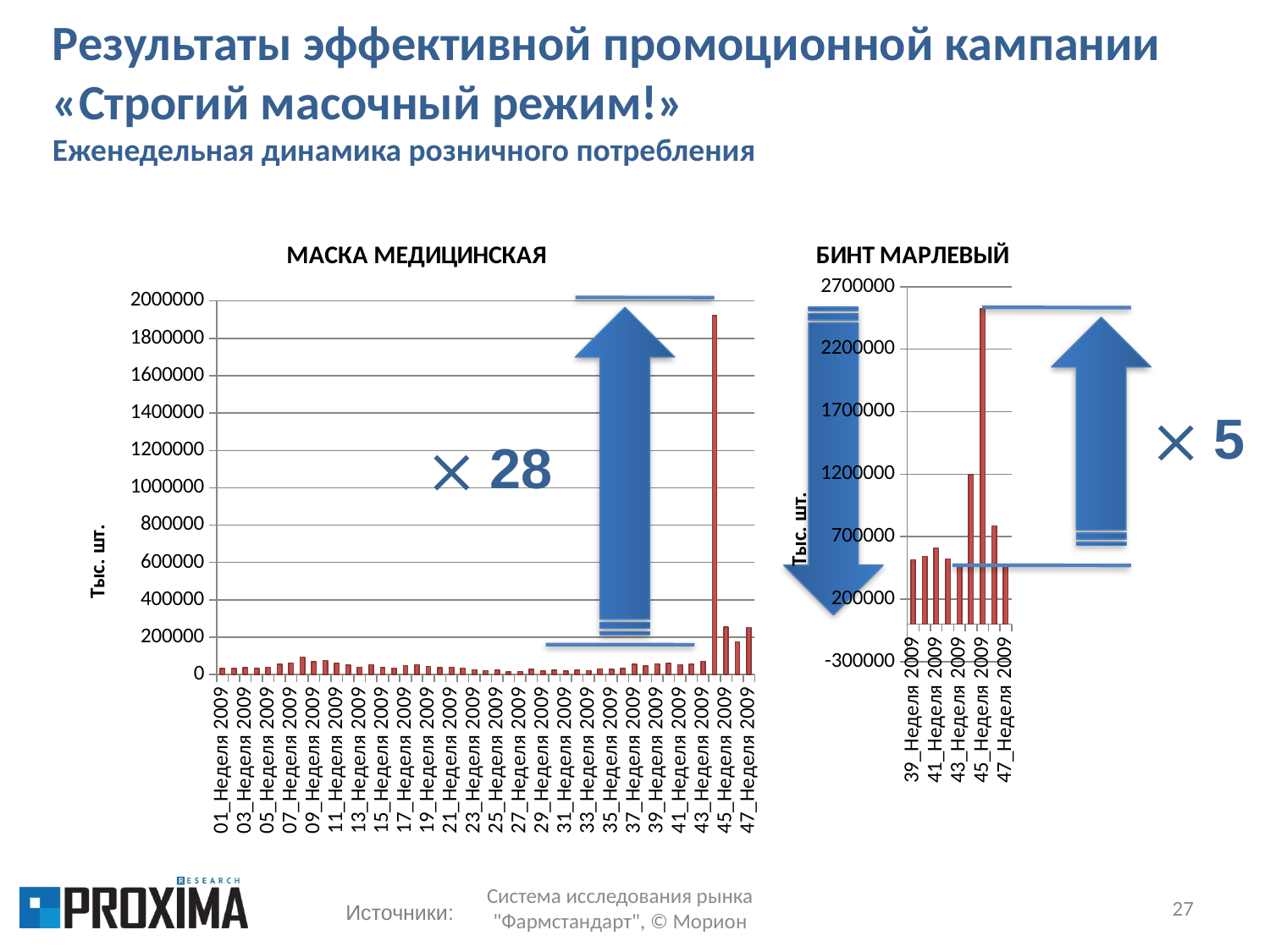
In the БИНТ МАРЛЕВЫЙ chart, is the value for 45_Неделя 2009 greater or less than 2200000? greater In the МАСКА МЕДИЦИНСКАЯ chart, is the value for 45_Неделя 2009 greater or less than 2000000? less In the БИНТ МАРЛЕВЫЙ chart, which week has the highest value? 45_Неделя 2009 In the БИНТ МАРЛЕВЫЙ chart, which is larger: the value for 45_Неделя 2009 or 41_Неделя 2009? 45_Неделя 2009 What multiplier is annotated on the БИНТ МАРЛЕВЫЙ chart? × 5 What kind of chart is the МАСКА МЕДИЦИНСКАЯ chart? Bar chart In the БИНТ МАРЛЕВЫЙ chart, is the value for 43_Неделя 2009 greater or less than 700000? less What is the y-axis label on the МАСКА МЕДИЦИНСКАЯ chart? Тыс. шт.